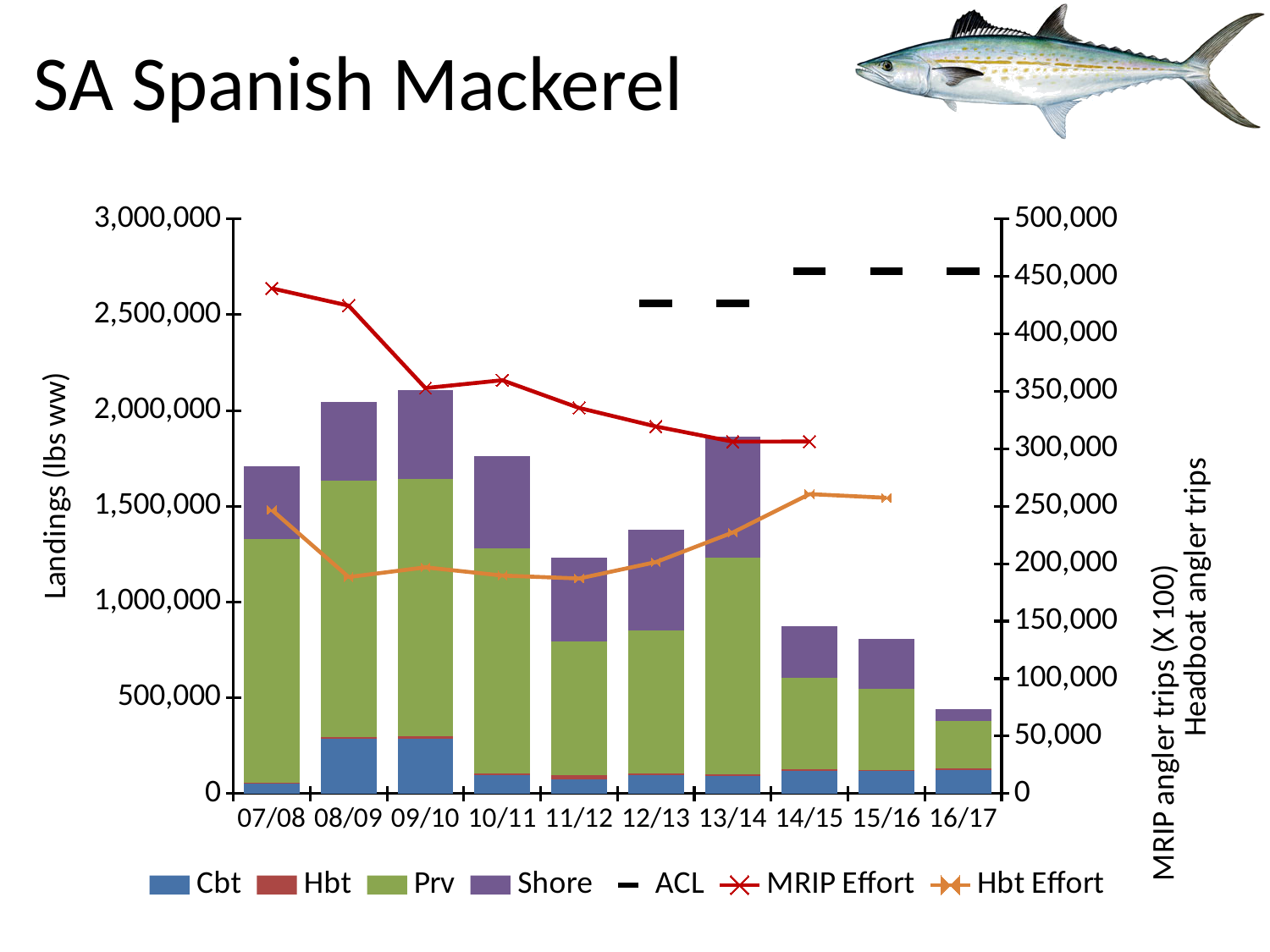
What is the title of the left vertical axis? Landings (lbs ww) In which fishing year is MRIP Effort highest? 07/08 Which fishing year has the lowest total landings bar? 16/17 Is the total landings bar for 14/15 greater or less than 1,000,000? less Does the MRIP Effort line rise or fall from 07/08 to 14/15? fall What kind of chart is shown on the slide? Stacked bar chart with line series Is the MRIP Effort value for 07/08 greater or less than 400,000? greater How many series does the legend list? 7 Is the total landings bar for 16/17 greater or less than 500,000? less How many fishing years are shown on the x axis? 10 Which is larger, the total landings bar for 08/09 or for 11/12? 08/09